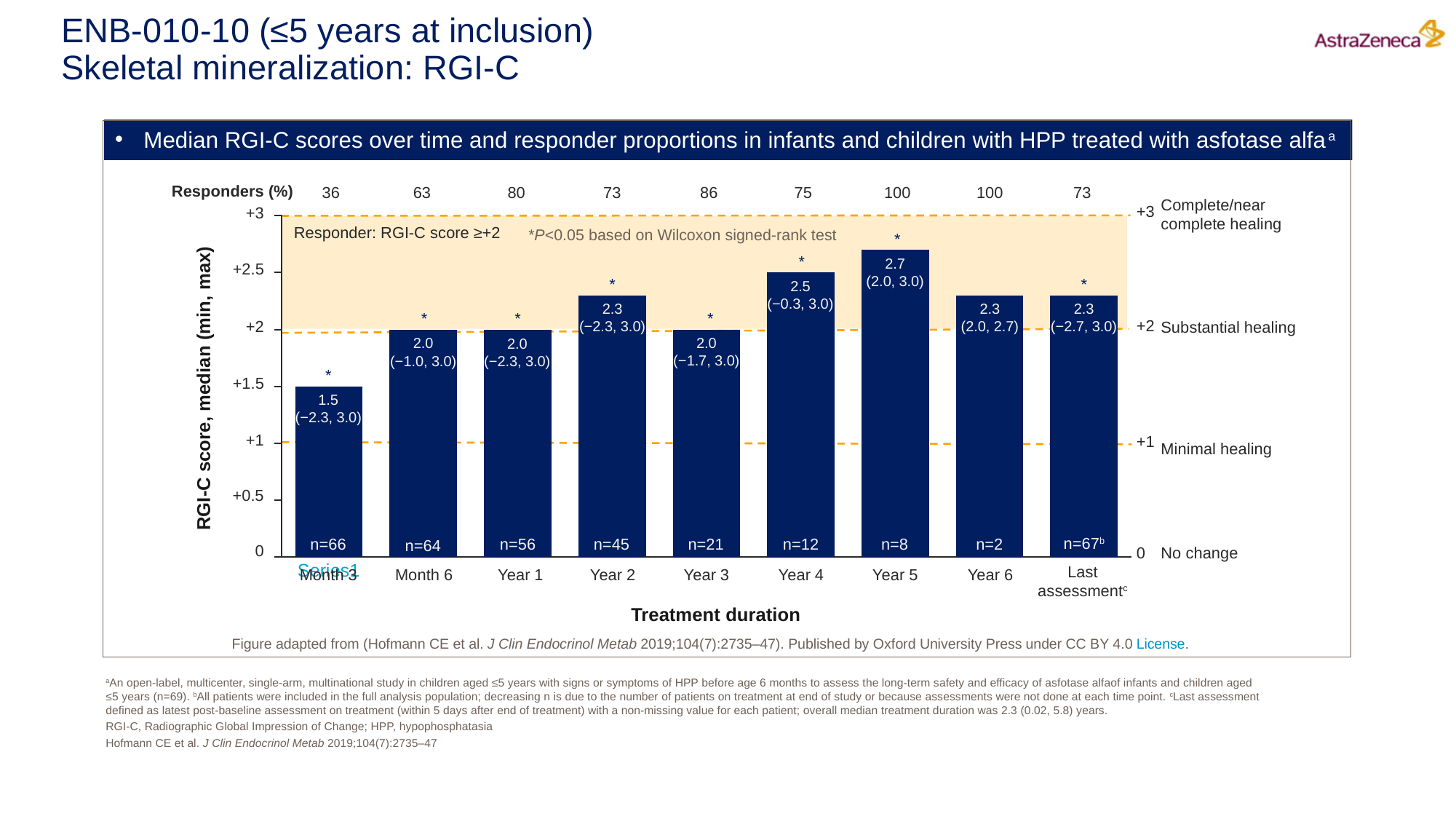
What is the responder percentage at Year 3? 86 What is the number of patients (n) at Year 6? n=2 Which treatment duration has the lowest median RGI-C score? Month 3 What kind of chart is used to show the median RGI-C scores? bar chart What is the x-axis title of the chart? Treatment duration What is the median RGI-C score at Month 3? 1.5 Is the median RGI-C score higher at Year 4 or at Year 3? Year 4 How many treatment duration categories are shown on the x axis? 9 What is the median RGI-C score at Year 5? 2.7 What is the difference between the median RGI-C score at Year 5 and at Month 3? 1.2 Is the median RGI-C score at Month 3 greater or less than +2? less Which treatment duration has the highest median RGI-C score? Year 5